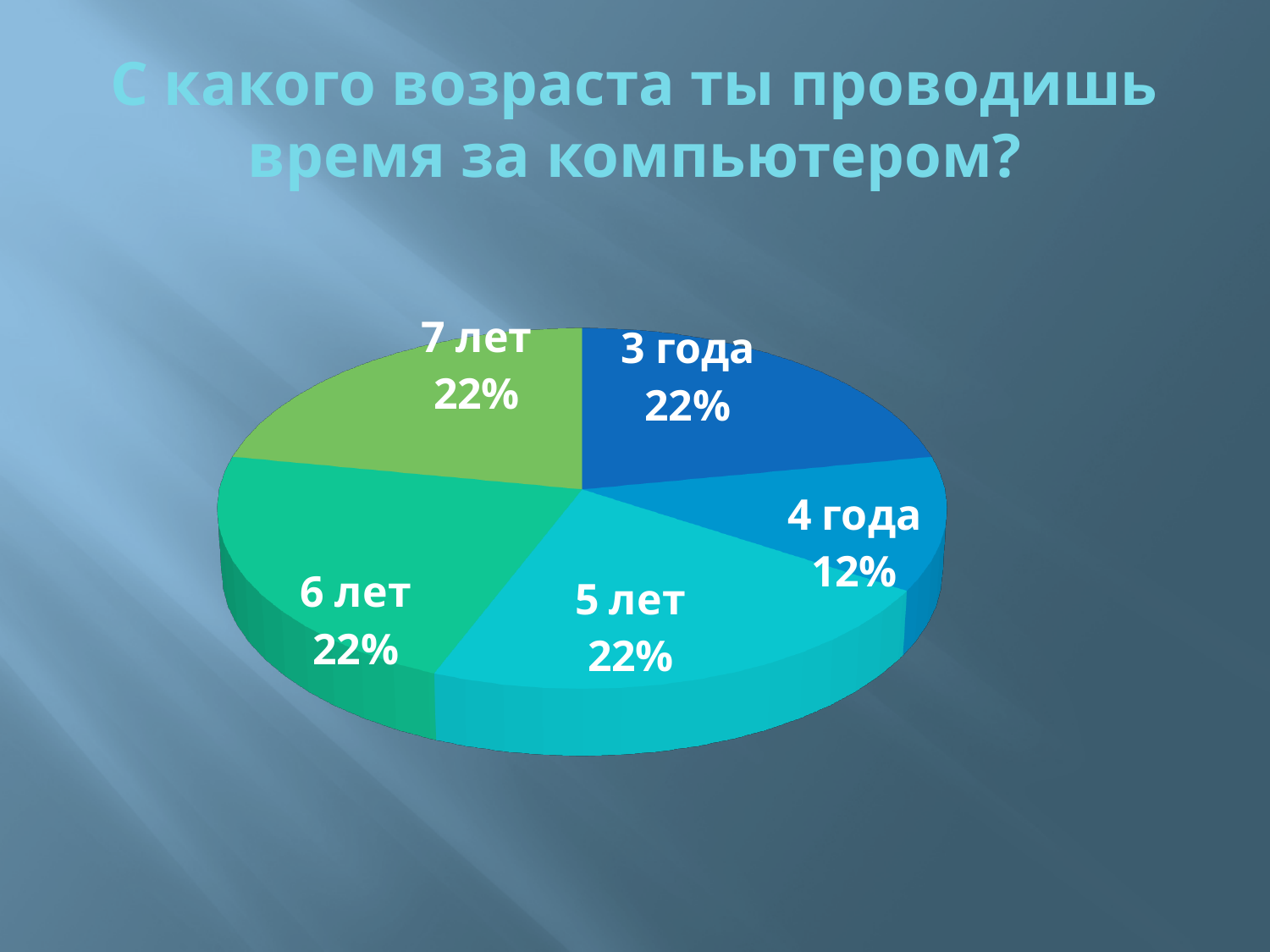
What percentage is shown for the "7 лет" slice? 22% What share of the pie does the "4 года" slice represent? 12% What kind of chart is shown on the slide? Pie chart What percentage is shown for the "5 лет" slice? 22% What percentage is shown for the "6 лет" slice? 22% Which category has the smallest share of the pie? 4 года What is the difference in percentage points between the "6 лет" slice and the "4 года" slice? 10 What percentage is shown for the "3 года" slice? 22% How many slices are labelled 22%? 4 What is the title of the slide? С какого возраста ты проводишь время за компьютером? Which is larger: the share for "3 года" or the share for "4 года"? 3 года How many slices does the pie chart have? 5